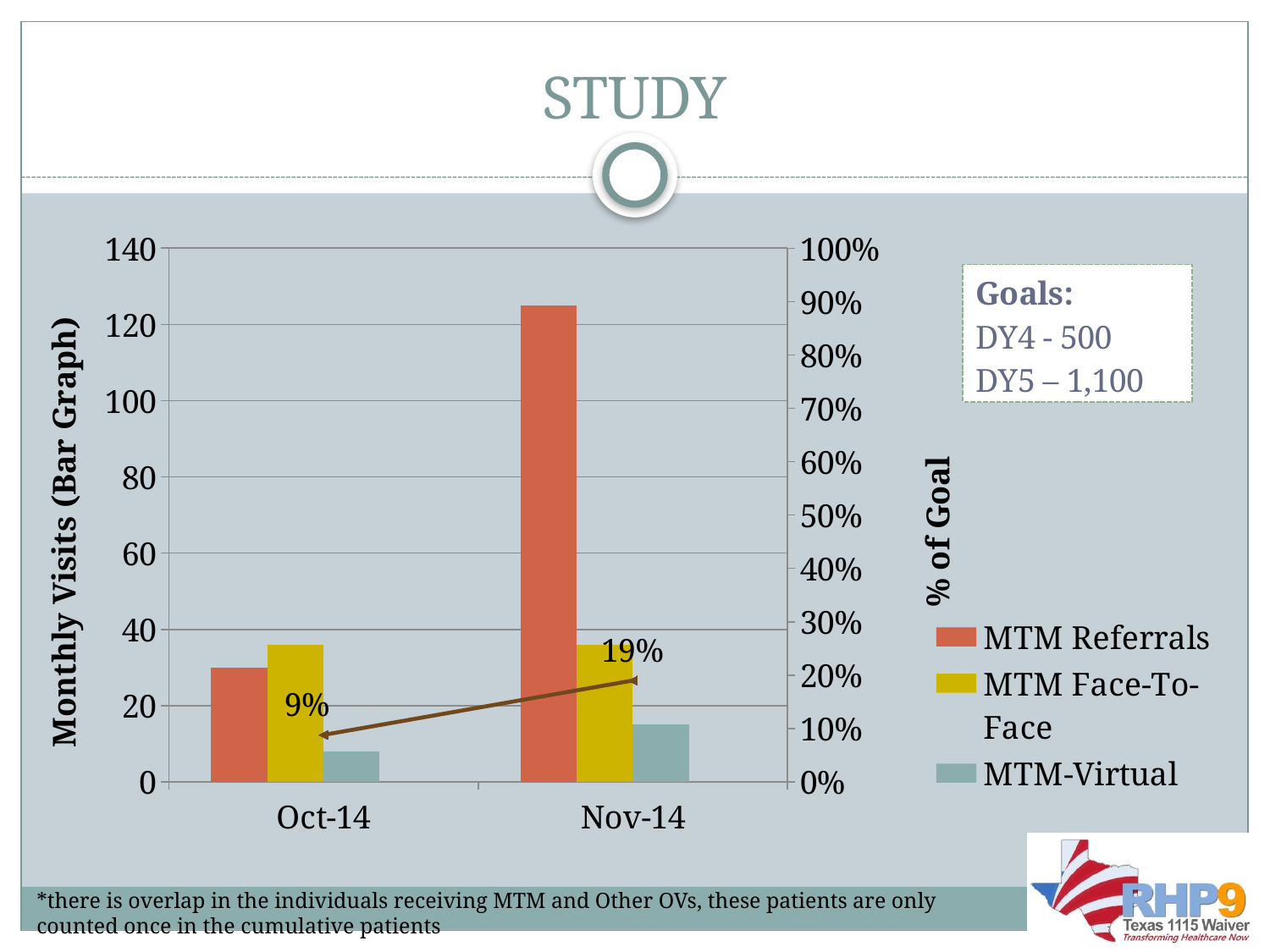
What is the title of the left vertical axis? Monthly Visits (Bar Graph) Does the % of Goal line rise or fall from Oct-14 to Nov-14? rises How many months are shown on the x axis? 2 Is the value for MTM Referrals in Nov-14 greater or less than 100? greater In Oct-14, which is larger: MTM Referrals or MTM Face-To-Face? MTM Face-To-Face Is the value for MTM-Virtual in Oct-14 greater or less than 20? less By how many percentage points does the % of Goal increase from Oct-14 to Nov-14? 10 percentage points Is the value for MTM Referrals in Oct-14 greater or less than 40? less What is the % of Goal value shown for Oct-14? 9% Which series has the highest bar in Nov-14? MTM Referrals How many series does the legend list? 3 What is the % of Goal value shown for Nov-14? 19%